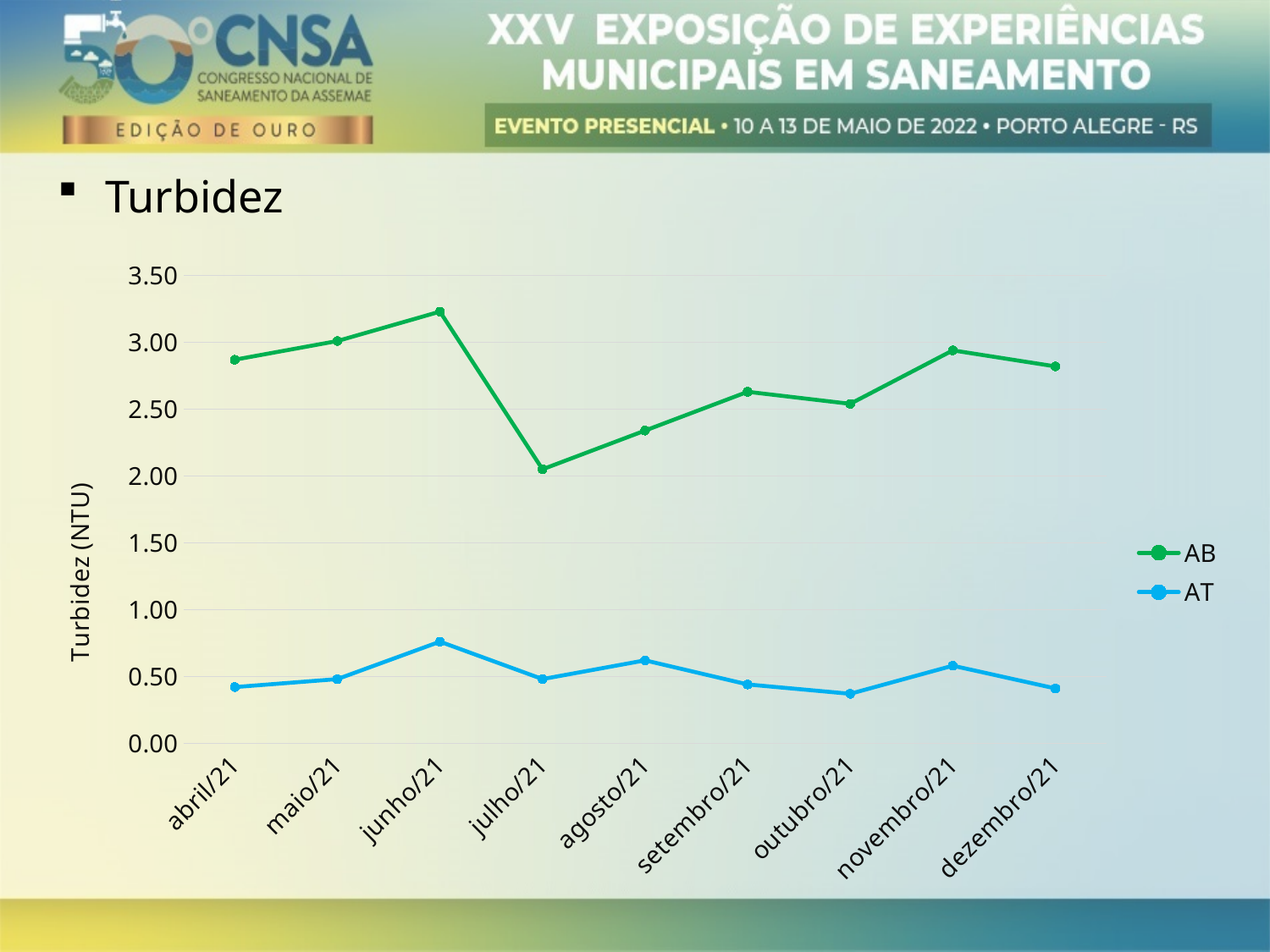
In which month does the AT series reach its highest value? junho/21 Is the AT value for junho/21 greater or less than 0.50? greater In which month does the AB series reach its lowest value? julho/21 What is the label of the y axis? Turbidez (NTU) In which month does the AT series reach its lowest value? outubro/21 Which series has the larger value in setembro/21, AB or AT? AB In which month does the AB series reach its highest value? junho/21 Is the AB value for junho/21 greater or less than 3.00? greater How many series does the legend list? 2 What kind of chart is shown on the slide? line chart How many months are plotted along the x axis? 9 Is the AB value for abril/21 greater or less than 3.00? less